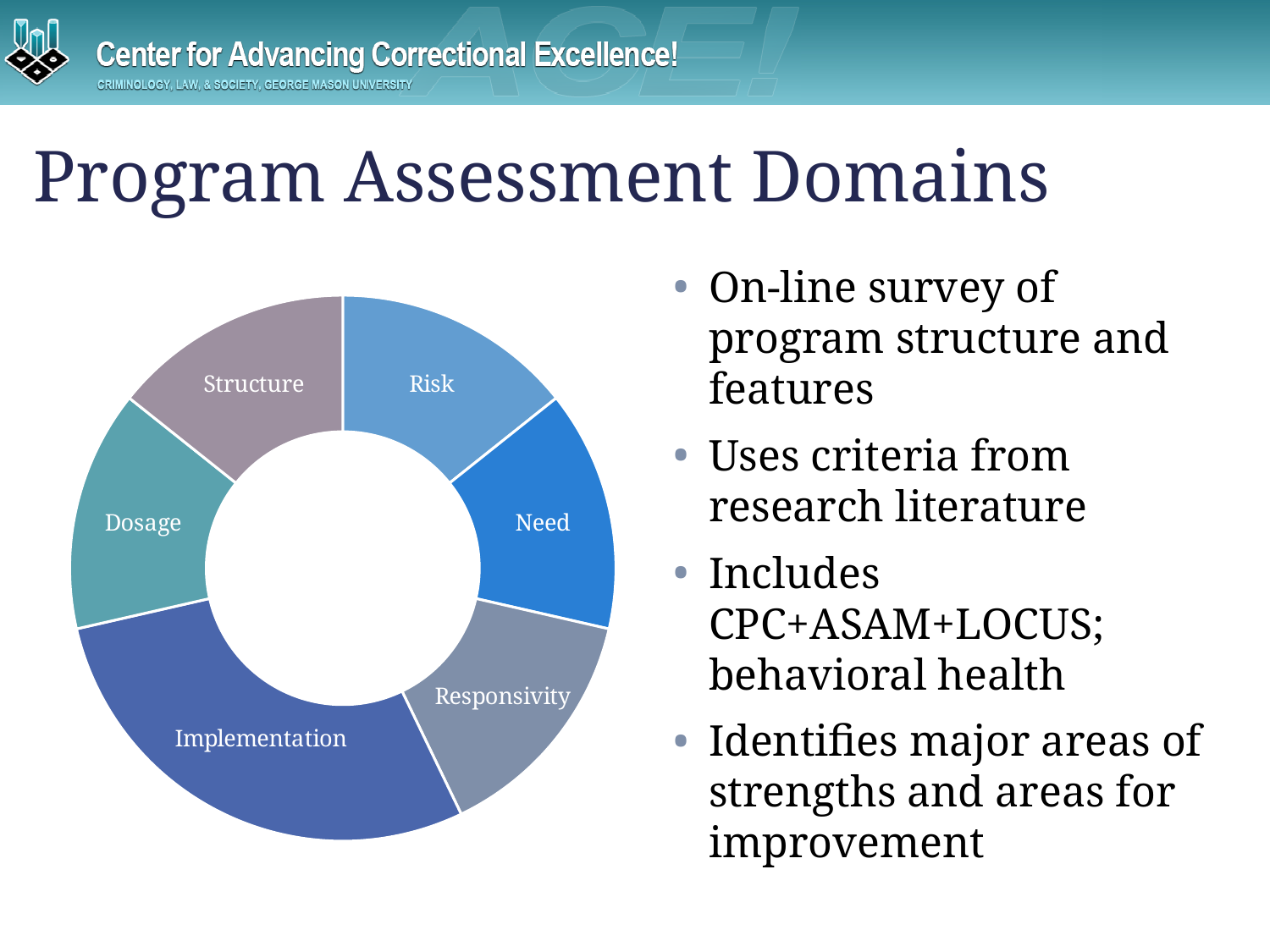
Which segment is larger, Implementation or Risk? Implementation How many segments does the doughnut chart have? 6 Which segment is larger, Implementation or Responsivity? Implementation Which segment of the doughnut chart is coloured dark blue? Implementation Which segment sits between Need and Implementation in the doughnut chart? Responsivity Which segment of the doughnut chart is the largest? Implementation Which segment of the doughnut chart is coloured teal? Dosage Which segment is larger, Implementation or Dosage? Implementation What kind of chart is shown on the slide? Doughnut chart